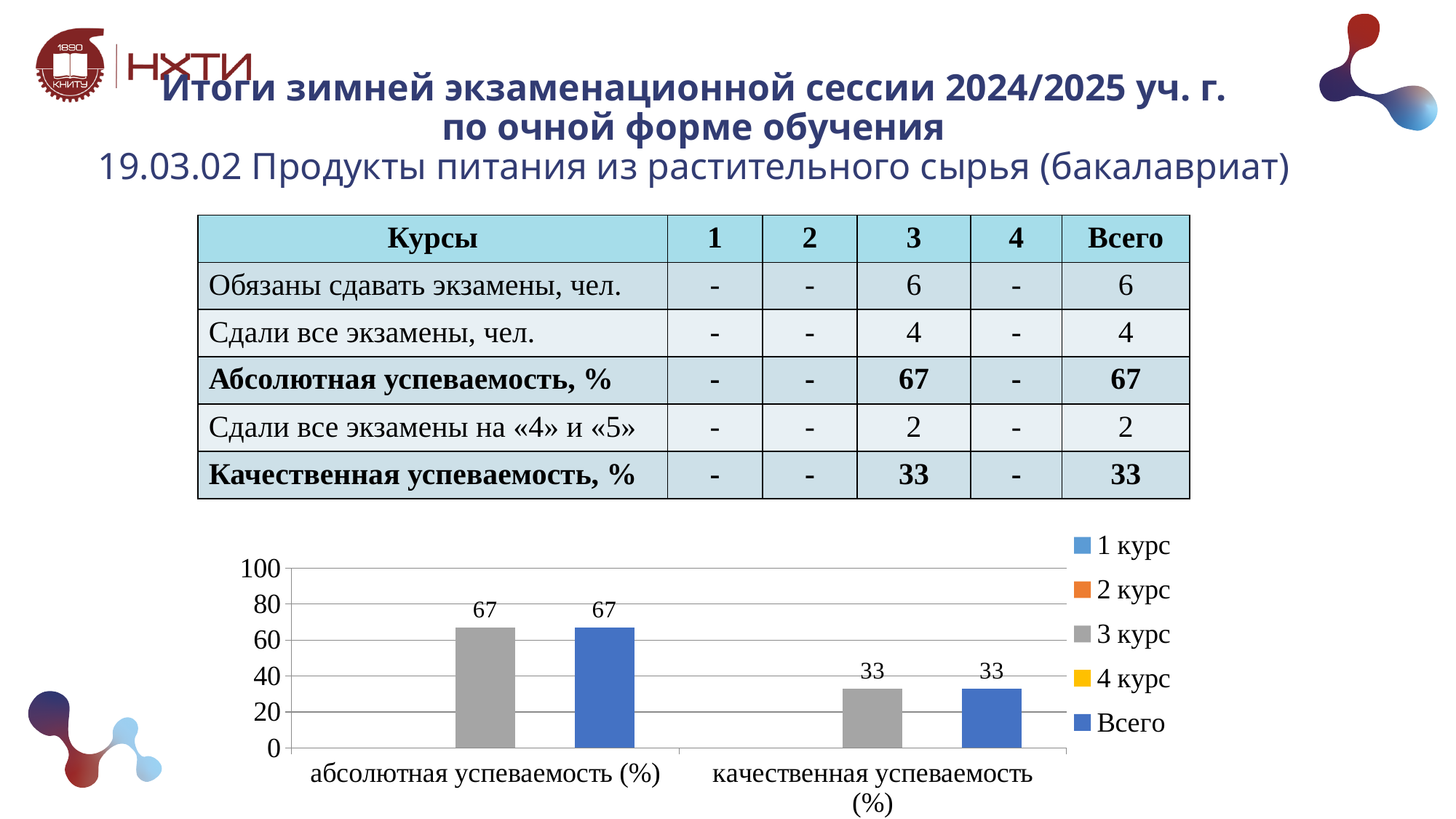
How many series does the chart legend list? 5 Which category has the highest value for the "Всего" series? абсолютная успеваемость (%) What is the value of the "Всего" bar for "качественная успеваемость (%)"? 33 What is the difference between the "Всего" values for "абсолютная успеваемость (%)" and "качественная успеваемость (%)"? 34 What is the last entry in the chart legend? Всего What is the value of the "3 курс" bar for "качественная успеваемость (%)"? 33 What is the value of the "3 курс" bar for "абсолютная успеваемость (%)"? 67 How many categories are shown on the x axis of the chart? 2 Is the "Всего" value for "абсолютная успеваемость (%)" greater or less than 60? greater What kind of chart is shown on the slide? bar chart Is the "3 курс" value for "качественная успеваемость (%)" greater or less than 40? less Which is larger for the "3 курс" series: "абсолютная успеваемость (%)" or "качественная успеваемость (%)"? абсолютная успеваемость (%)